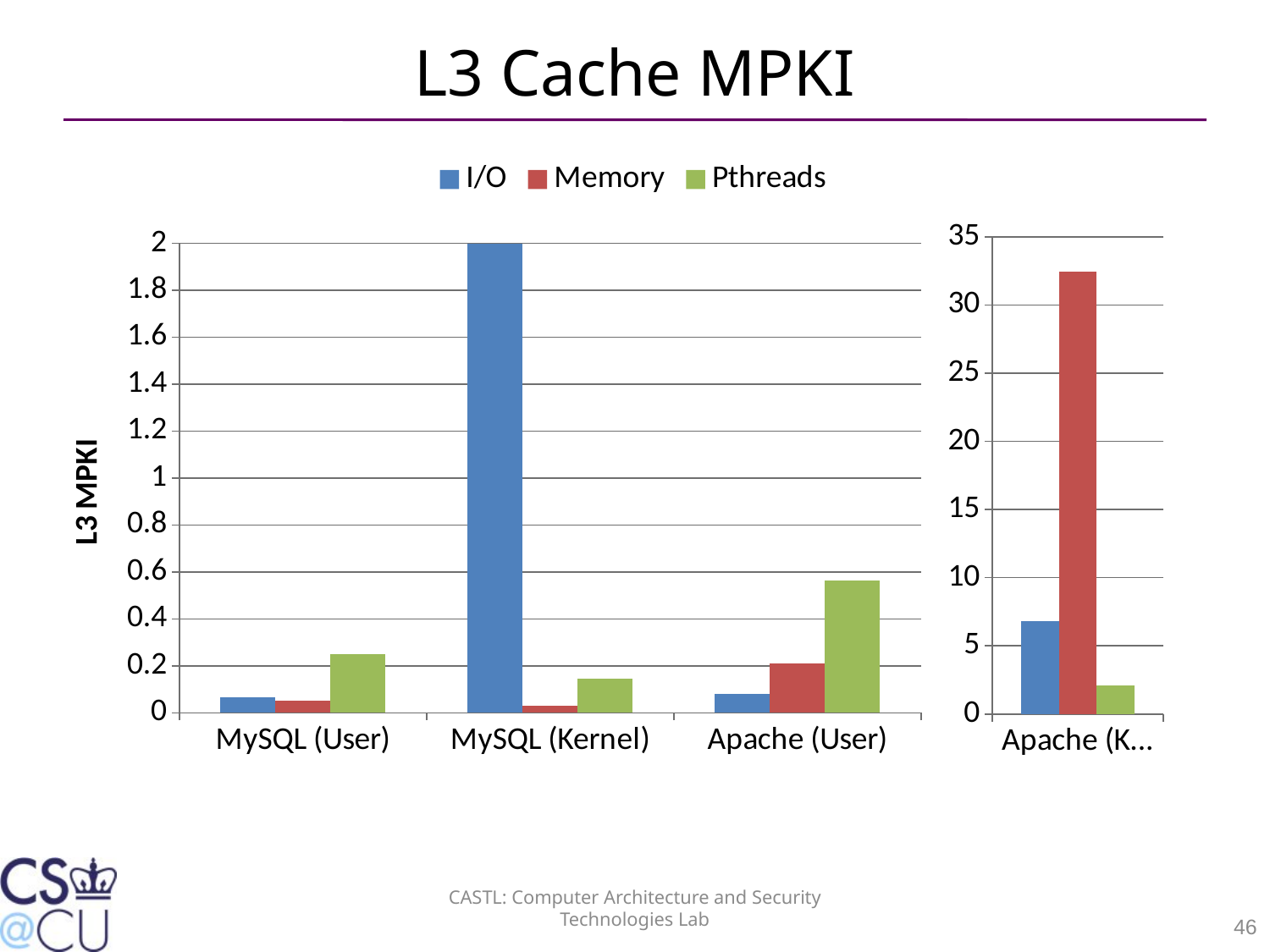
How many series does the legend list? 3 What kind of chart is shown on the slide? bar chart In the left chart, which is larger for MySQL (Kernel): I/O or Pthreads? I/O In the right chart, is the I/O value for Apache (Kernel) greater or less than 10? less In the left chart, which series has the highest value for Apache (User)? Pthreads In the right chart (Apache Kernel), which series has the lowest value? Pthreads In the left chart, how many categories are shown on the x axis? 3 In the right chart (Apache Kernel), which series has the highest value? Memory What is the y-axis title of the left chart? L3 MPKI In the left chart, is the Pthreads value for MySQL (User) greater or less than 0.2? greater In the right chart, is the Memory value for Apache (Kernel) greater or less than 30? greater